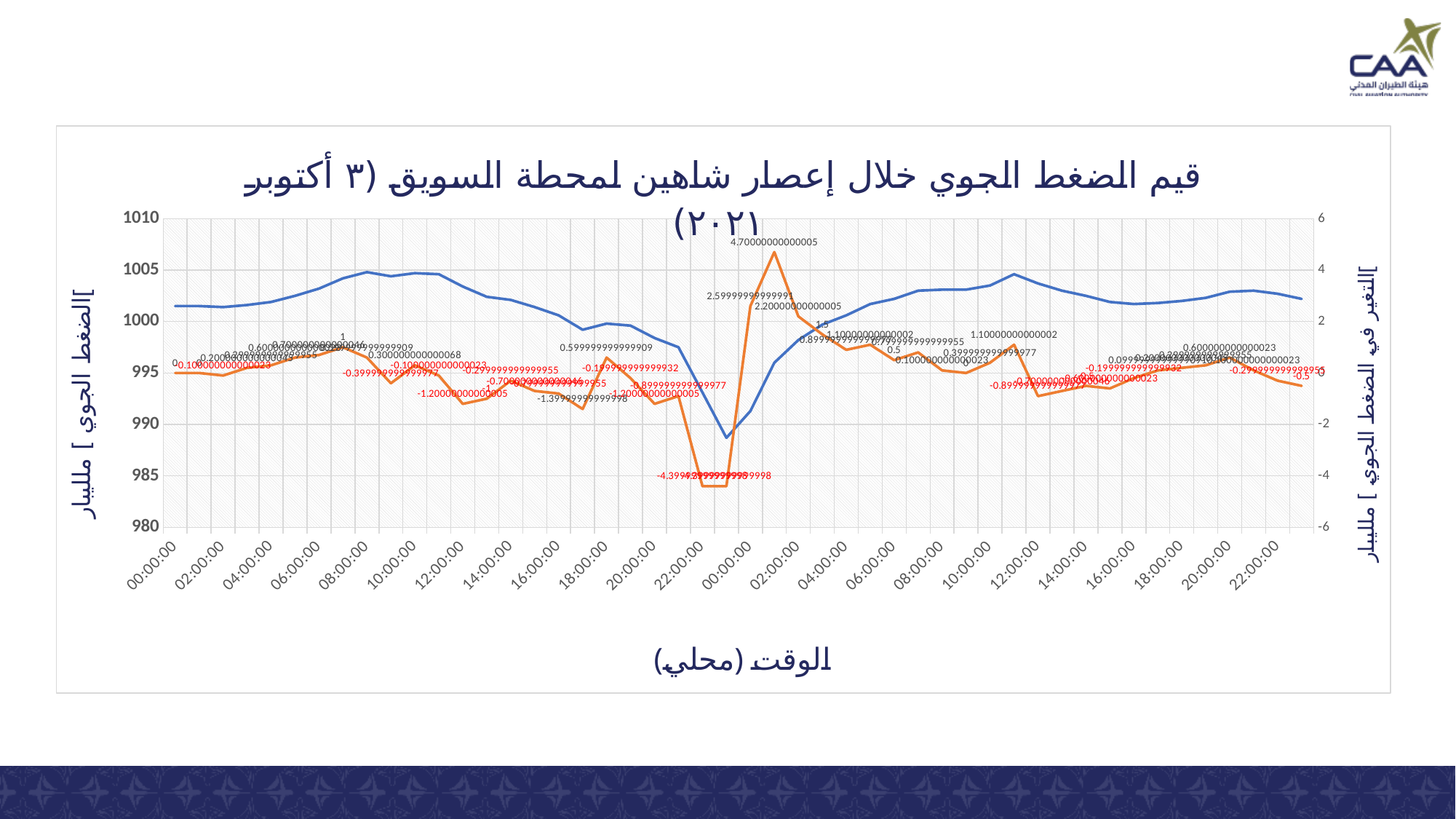
Is the lowest value of the orange line greater or less than -4? less Is the lowest value of the blue line greater or less than 990? less Is the value of the blue line at the first 22:00:00 greater or less than 995? less What is the x-axis title of the chart? الوقت (محلي) Does the blue line rise or fall between the first 18:00:00 and the second 00:00:00? fall Does the orange line rise or fall between the second 00:00:00 and the second 02:00:00? fall What is the title of the chart? قيم الضغط الجوي خلال إعصار شاهين لمحطة السويق (٣ أكتوبر ٢٠٢١) What is the highest value labelled on the orange line? 4.70000000000005 How many lines are plotted on the chart? 2 Which is larger for the blue line: the value at the first 00:00:00 or the value at the second 00:00:00? the first 00:00:00 What kind of chart is shown on the slide? line chart